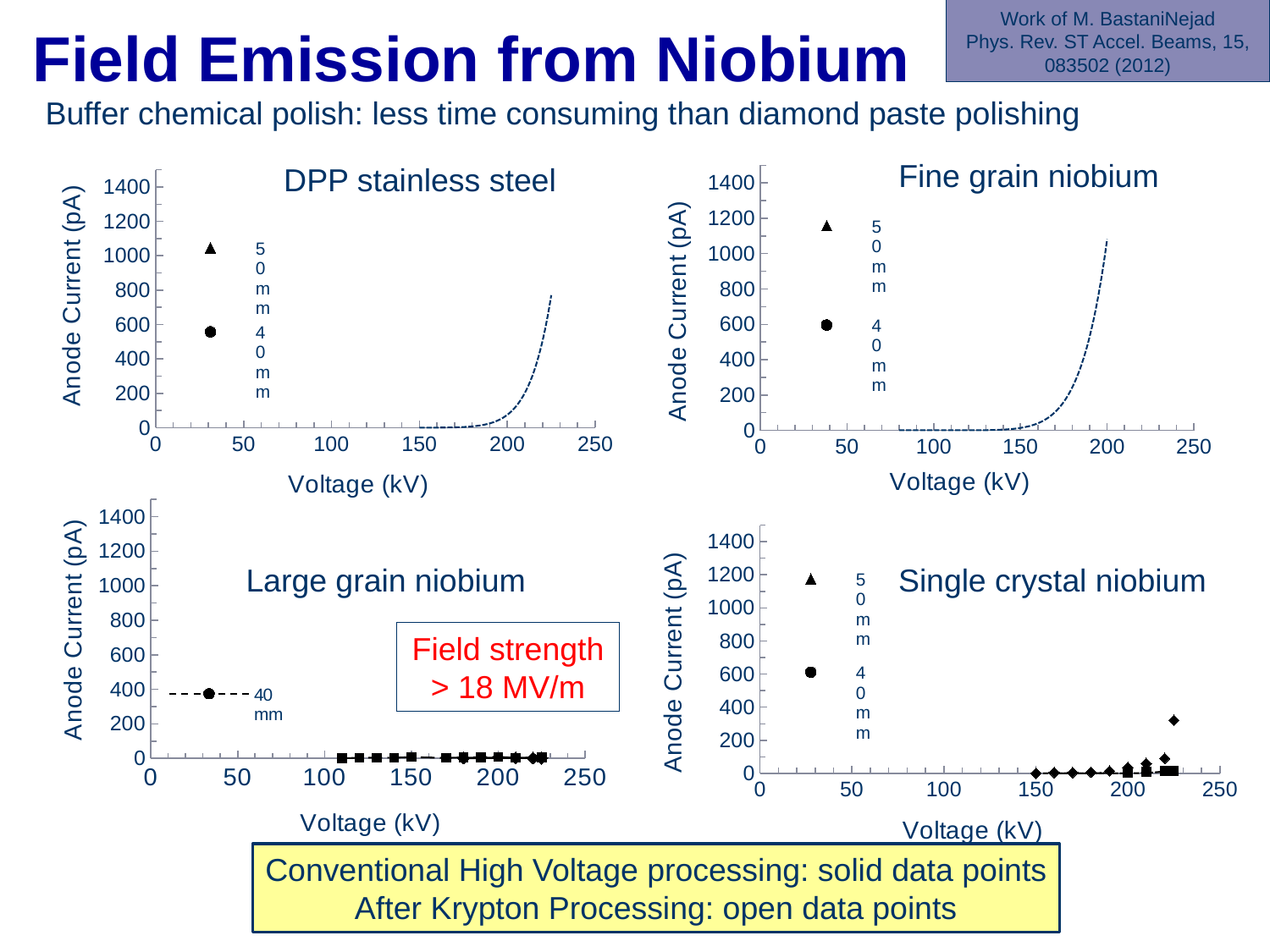
How many series does the legend of the Large grain niobium chart list? 1 What is the y-axis label of the Fine grain niobium chart? Anode Current (pA) In the Single crystal niobium chart, is the highest plotted anode current greater or less than 200? greater How many series does the legend of the DPP stainless steel chart list? 2 In the DPP stainless steel chart, does the anode current rise or fall as voltage increases along the x axis? rise In the Single crystal niobium chart, is the highest plotted anode current greater or less than 400? less What is the x-axis label of the Single crystal niobium chart? Voltage (kV) How many charts are shown on the slide? 4 In the Large grain niobium chart, is the anode current at 150 kV greater or less than 200? less What kind of chart is the DPP stainless steel chart? line chart